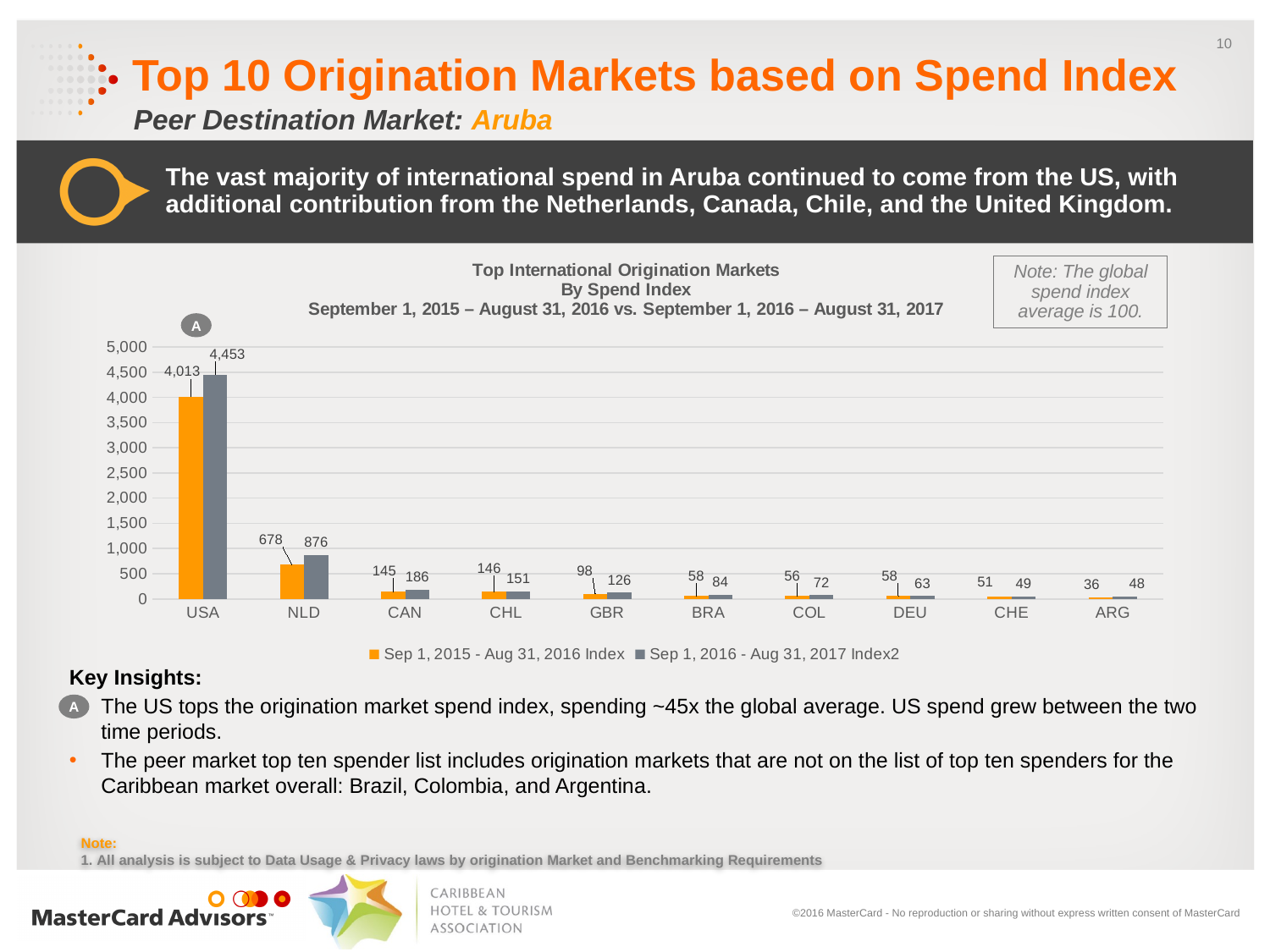
How many origination markets are shown on the x axis of the chart? 10 What is the Sep 1, 2016 - Aug 31, 2017 spend index value for CAN? 186 What is the Sep 1, 2015 - Aug 31, 2016 spend index value for NLD? 678 What kind of chart is shown on the slide? Bar chart How many series does the chart legend list? 2 Is the Sep 1, 2016 - Aug 31, 2017 spend index for NLD greater or less than 1,000? less What is the difference between the USA spend index in the Sep 1, 2016 - Aug 31, 2017 period and the Sep 1, 2015 - Aug 31, 2016 period? 440 Which is larger for CHE: the Sep 1, 2015 - Aug 31, 2016 index or the Sep 1, 2016 - Aug 31, 2017 index? Sep 1, 2015 - Aug 31, 2016 Index Which origination market has the lowest spend index in the Sep 1, 2015 - Aug 31, 2016 period? ARG What is the Sep 1, 2016 - Aug 31, 2017 spend index value for GBR? 126 Which origination market has the highest spend index in the Sep 1, 2016 - Aug 31, 2017 period? USA What is the Sep 1, 2016 - Aug 31, 2017 spend index value for USA? 4,453